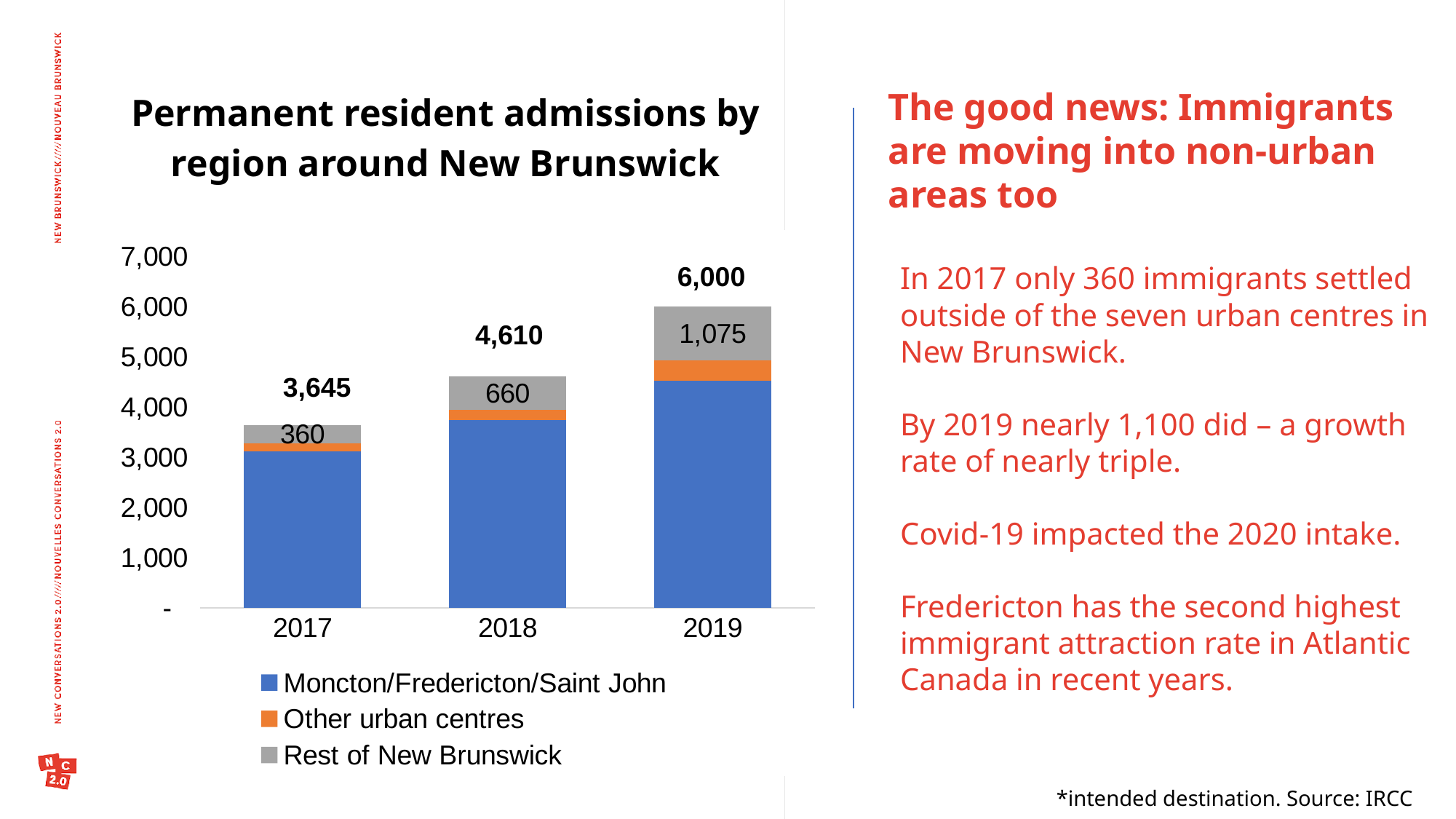
What value is labelled for Rest of New Brunswick in 2019? 1,075 By how much did the Rest of New Brunswick value increase from 2017 to 2019? 715 What value is labelled for Rest of New Brunswick in 2018? 660 Which year has the lowest total admissions? 2017 What is the total permanent resident admissions shown for 2019? 6,000 What is the difference between the total admissions in 2019 and 2017? 2,355 What is the total permanent resident admissions shown for 2017? 3,645 How many years are shown on the x axis? 3 Is the Moncton/Fredericton/Saint John value for 2019 greater or less than 4,000? greater How many series does the legend list? 3 Which year has the highest total admissions? 2019 Do the total admissions rise or fall from 2017 to 2019? rise